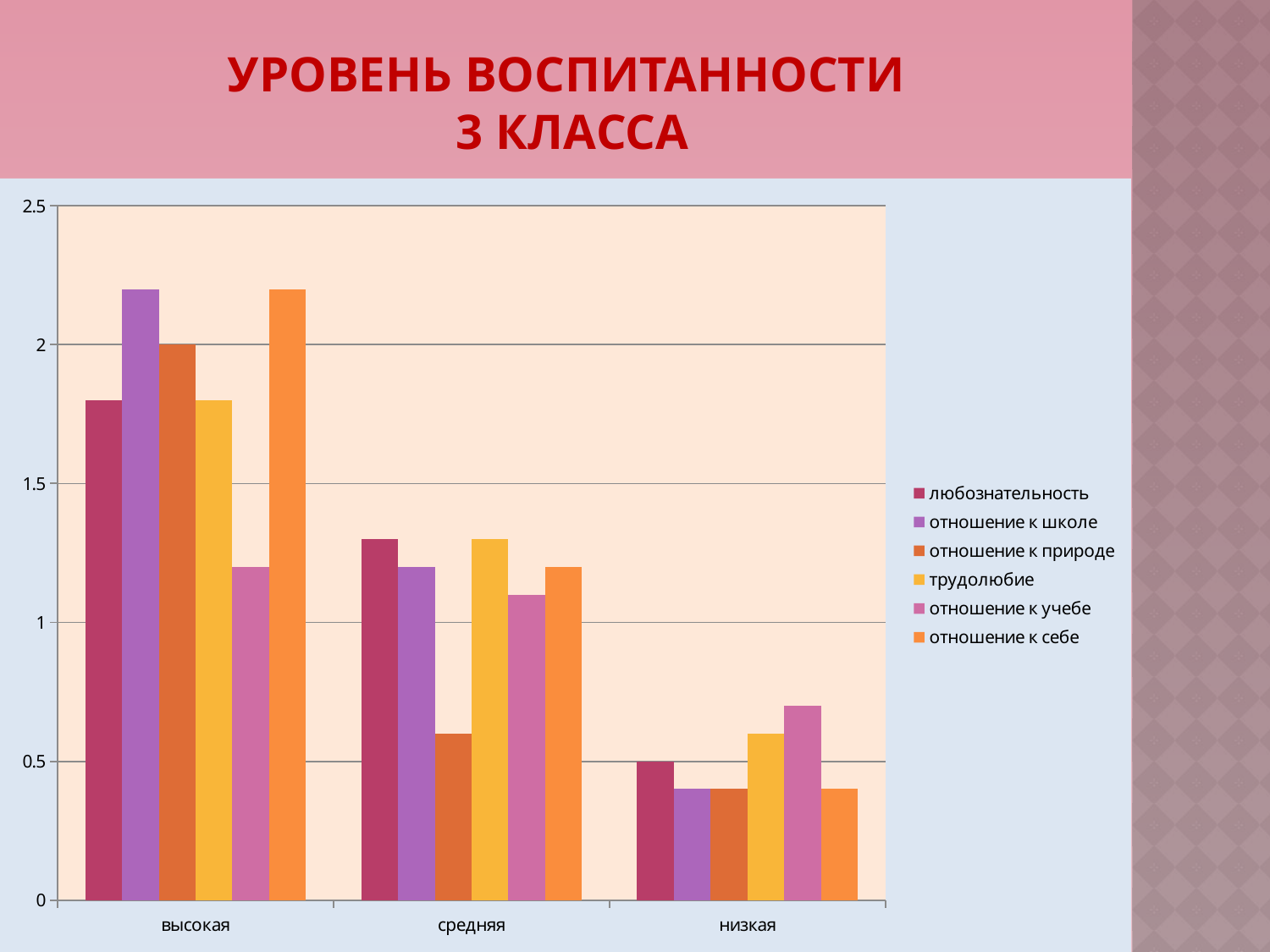
How many series does the legend list? 6 Is the value for "отношение к школе" in the "низкая" category greater or less than 0.5? less Which series has the lowest value in the "средняя" category? отношение к природе What is the title of the slide? УРОВЕНЬ ВОСПИТАННОСТИ 3 КЛАССА How many categories are shown on the x axis? 3 Do the values for "любознательность" rise or fall from "высокая" to "низкая"? fall Is the value for "отношение к учебе" in the "высокая" category greater or less than 1.5? less Which series has the highest value in the "низкая" category? отношение к учебе Which series has the lowest value in the "высокая" category? отношение к учебе Is the value for "отношение к школе" in the "высокая" category greater or less than 2? greater What kind of chart is shown on the slide? bar chart